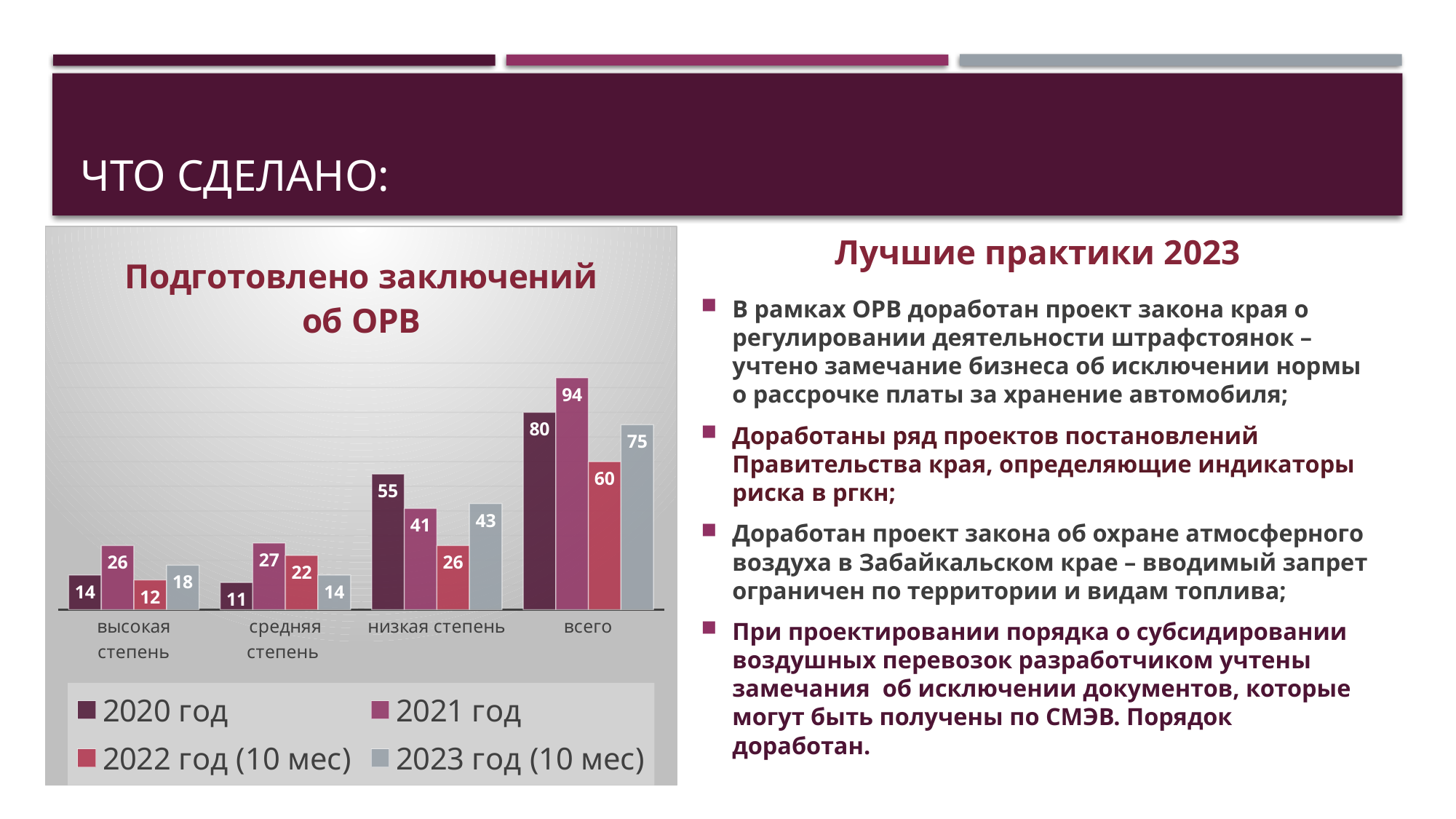
What is the difference between the 2020 год and 2022 год (10 мес) values in the всего category? 20 What is the value for 2021 год in the всего category? 94 What is the value for 2022 год (10 мес) in the средняя степень category? 22 What is the title of the chart on the slide? Подготовлено заключений об ОРВ How many series does the chart legend list? 4 Which year has the highest value in the всего category? 2021 год Which year has the lowest value in the высокая степень category? 2022 год (10 мес) Which category has the highest value for 2020 год? всего What type of chart is shown on the slide? bar chart What is the value for 2023 год (10 мес) in the низкая степень category? 43 How many categories are shown on the x axis of the chart? 4 In the низкая степень category, which is larger: the value for 2020 год or for 2021 год? 2020 год